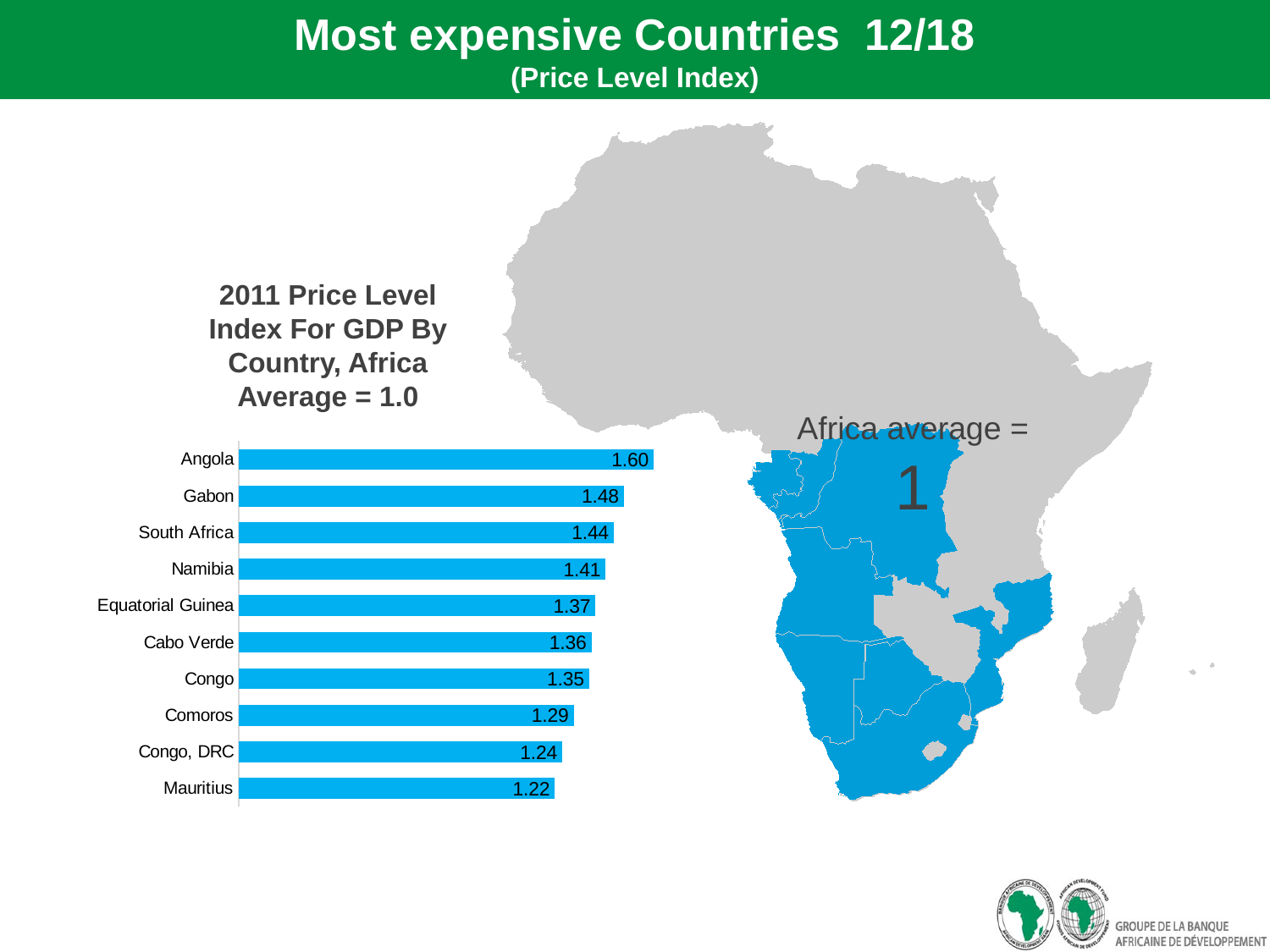
What is the difference between the price level index of South Africa and Mauritius? 0.22 Which country has the highest price level index on the chart? Angola What is the price level index value for Mauritius? 1.22 Which country has the lowest price level index on the chart? Mauritius Which has a higher price level index, Congo or Congo, DRC? Congo How many countries are shown on the bar chart? 10 What type of chart is used to show the price level index by country? Bar chart What is the price level index value for Cabo Verde? 1.36 Which has a higher price level index, Namibia or Comoros? Namibia What is the title of the chart? 2011 Price Level Index For GDP By Country, Africa Average = 1.0 What is the difference between the price level index of Angola and Gabon? 0.12 What is the price level index value for Angola? 1.60